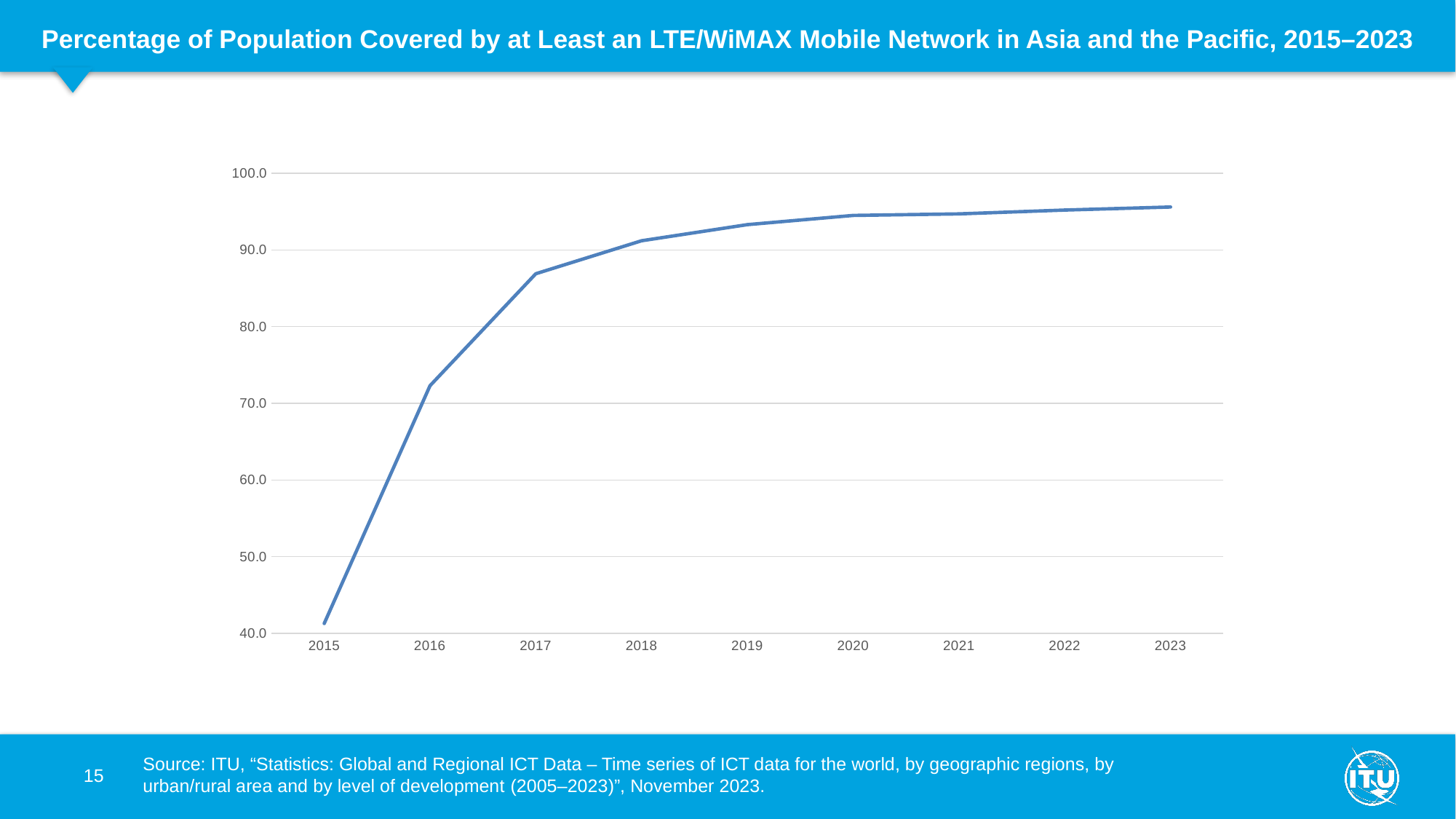
How many years are plotted on the x axis of the chart? 9 Do the values rise or fall from 2015 to 2023? Rise Is the value for 2017 greater or less than 90.0? less What region does the chart title say the data covers? Asia and the Pacific Is the value for 2023 greater or less than 100.0? less Is the value for 2018 greater or less than 90.0? greater What kind of chart is shown on the slide? Line chart Which year has the larger value, 2016 or 2017? 2017 Which year has the lowest percentage of population covered by at least an LTE/WiMAX mobile network? 2015 Which year has the larger value, 2015 or 2019? 2019